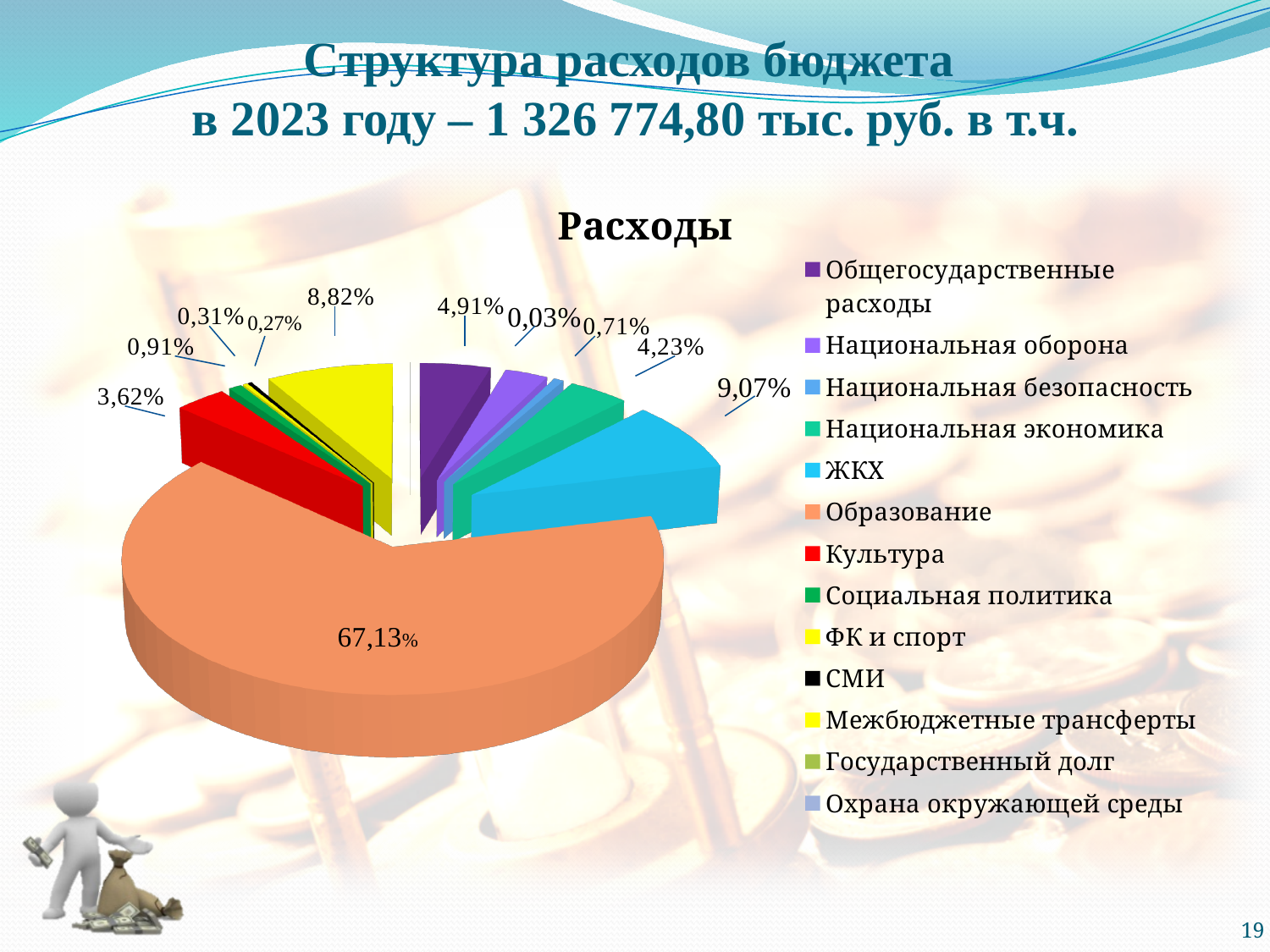
What share of the pie does Образование have? 67,13% Which is larger, the share for ЖКХ or the share for Культура? ЖКХ What share of the pie does ЖКХ have? 9,07% What share of the pie does ФК и спорт have? 0,31% What is the difference between the shares of Образование and ЖКХ? 58,06% Which category has the largest share of the pie? Образование How many categories does the chart legend list? 13 What kind of chart is shown on the slide? pie chart What is the smallest percentage label shown on the chart? 0,03% What is the title of the chart? Расходы